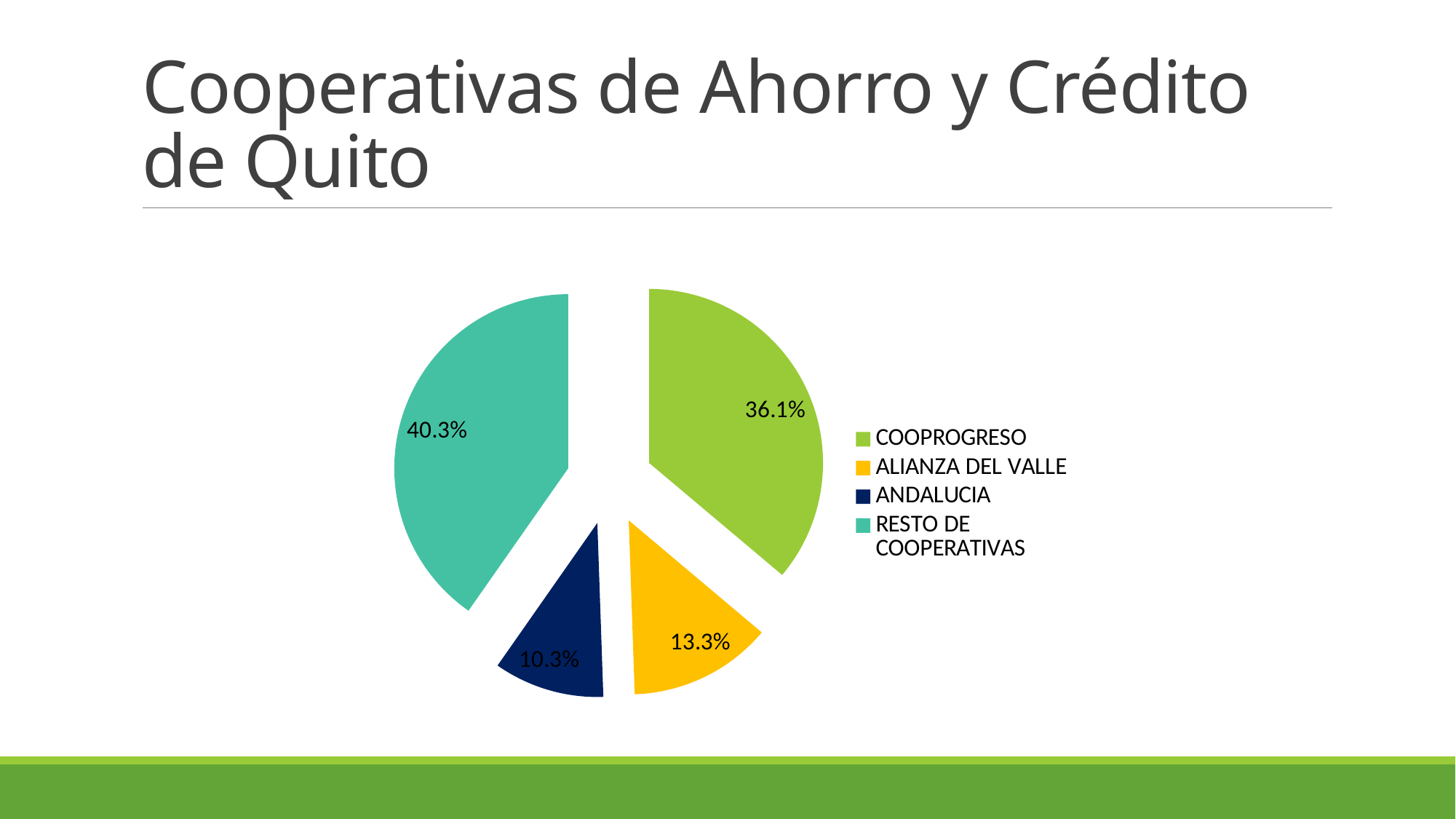
What share of the pie does RESTO DE COOPERATIVAS hold? 40.3% Which category has the smallest slice of the pie? ANDALUCIA What share of the pie does ALIANZA DEL VALLE hold? 13.3% How many slices does the pie chart have? 4 What kind of chart is shown on the slide? Pie chart What is the difference in percentage points between ALIANZA DEL VALLE and ANDALUCIA? 3 What share of the pie does ANDALUCIA hold? 10.3% What colour is the slice for ANDALUCIA? Dark blue What is the difference in percentage points between RESTO DE COOPERATIVAS and COOPROGRESO? 4.2 What share of the pie does COOPROGRESO hold? 36.1% Which category has the largest slice of the pie? RESTO DE COOPERATIVAS Which is larger, the share for COOPROGRESO or the share for ALIANZA DEL VALLE? COOPROGRESO